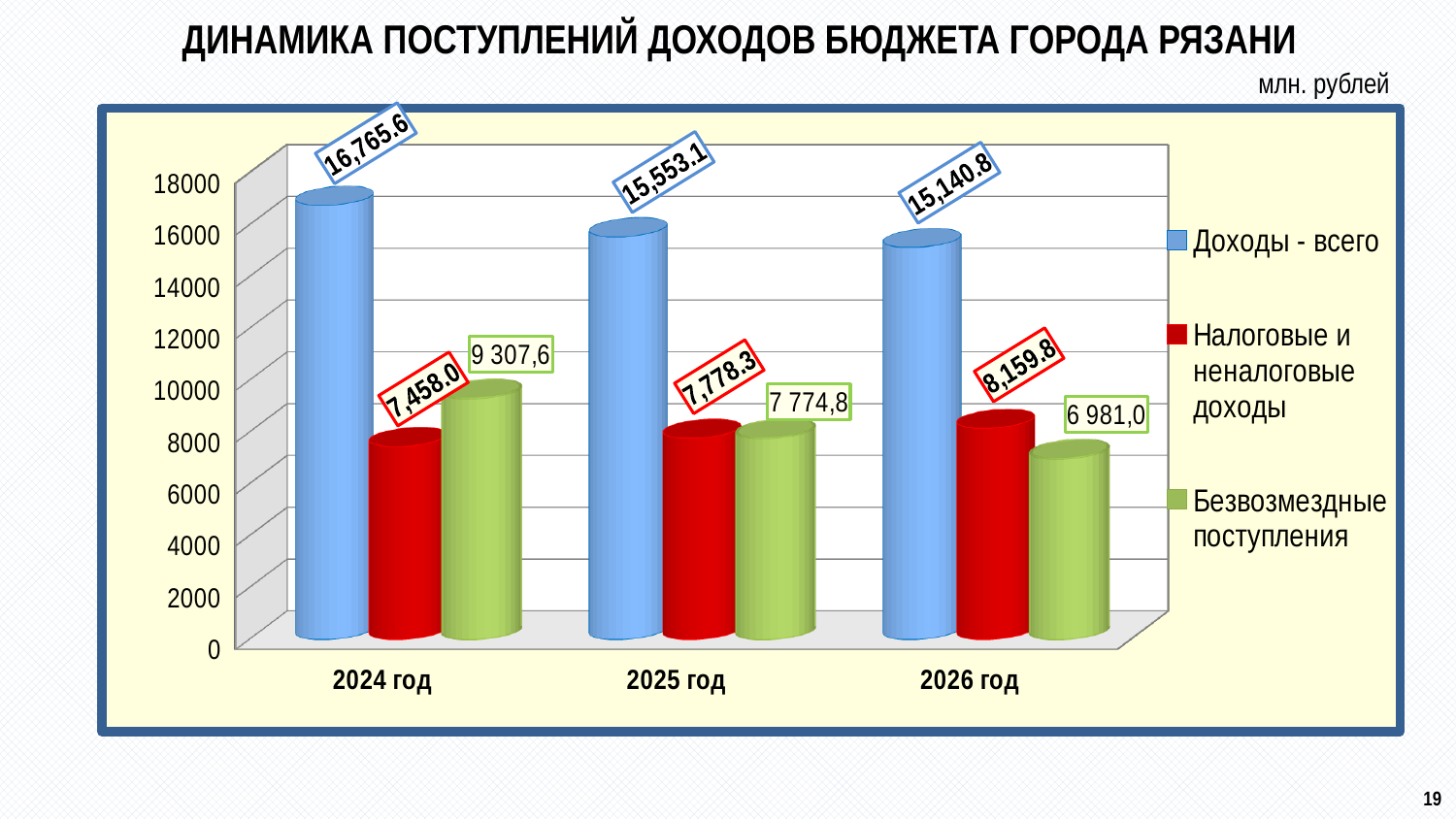
In which year is Налоговые и неналоговые доходы the lowest? 2024 год What unit is stated for the values on the chart? млн. рублей In which year is Доходы - всего the highest? 2024 год How many series does the legend list? 3 What kind of chart is shown on the slide? bar chart What is the value of Налоговые и неналоговые доходы for 2025 год? 7,778.3 Which is larger in 2025 год: Налоговые и неналоговые доходы or Безвозмездные поступления? Налоговые и неналоговые доходы What is the value of Безвозмездные поступления for 2024 год? 9 307,6 What is the value of Безвозмездные поступления for 2026 год? 6 981,0 Does Доходы - всего rise or fall from 2024 год to 2026 год? fall What is the value of Доходы - всего for 2024 год? 16,765.6 What is the difference between Доходы - всего in 2024 год and in 2026 год? 1,624.8